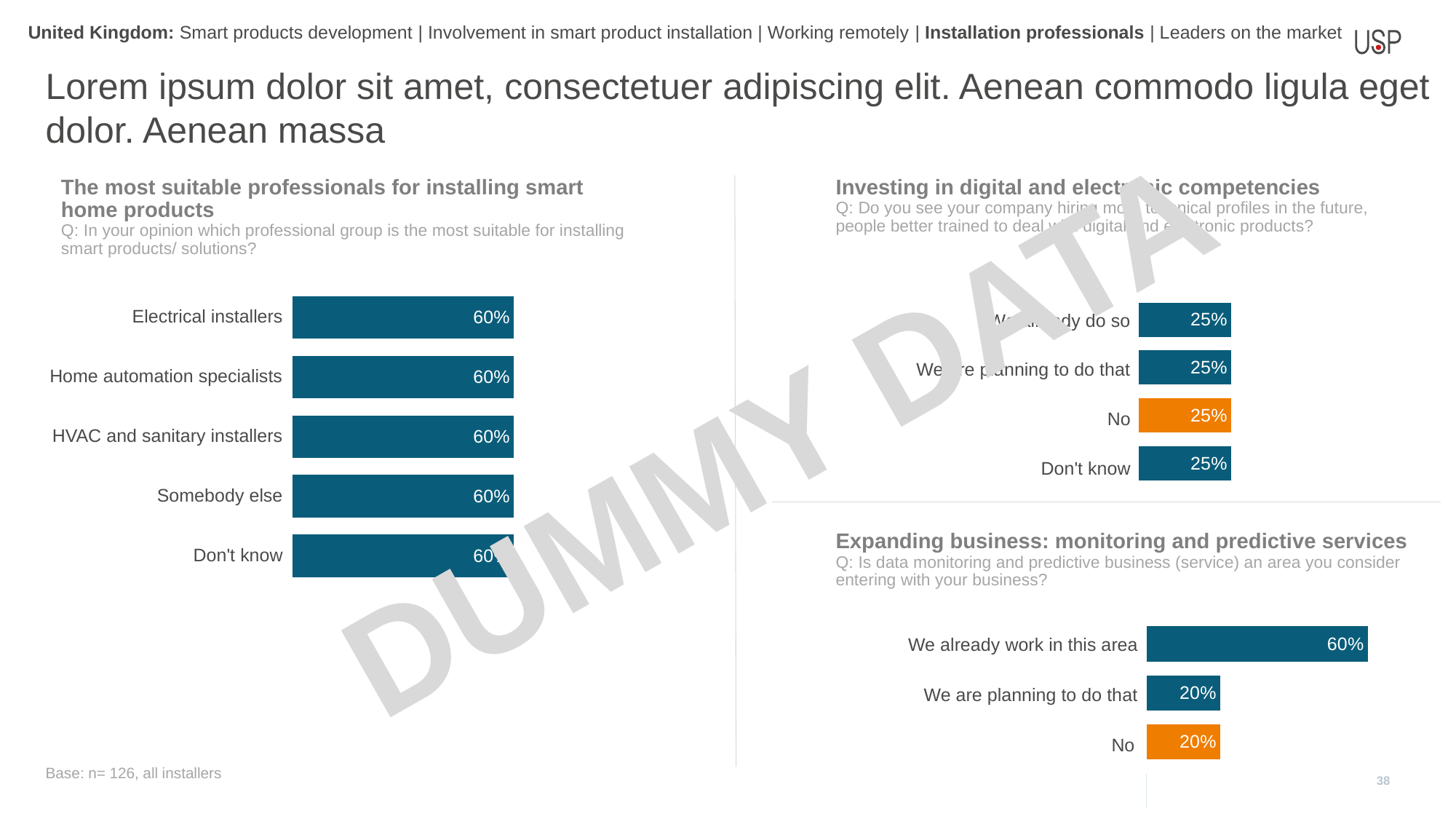
What kind of chart is 'The most suitable professionals for installing smart home products'? Bar chart In the chart 'Expanding business: monitoring and predictive services', what is the value for 'We already work in this area'? 60% How many categories are shown in the chart 'Investing in digital and electronic competencies'? 4 In the chart 'Expanding business: monitoring and predictive services', which is larger: 'We already work in this area' or 'We are planning to do that'? We already work in this area In the chart 'Expanding business: monitoring and predictive services', which bar is coloured orange? No In the chart 'Expanding business: monitoring and predictive services', which category has the highest value? We already work in this area How many categories are shown in the chart 'The most suitable professionals for installing smart home products'? 5 In the chart 'The most suitable professionals for installing smart home products', what is the value for HVAC and sanitary installers? 60% In the chart 'Investing in digital and electronic competencies', what is the value for 'No'? 25% In the chart 'Investing in digital and electronic competencies', what is the value for 'Don't know'? 25% In the chart 'Expanding business: monitoring and predictive services', what is the difference between 'We already work in this area' and 'No'? 40% In the chart 'The most suitable professionals for installing smart home products', what is the value for Electrical installers? 60%